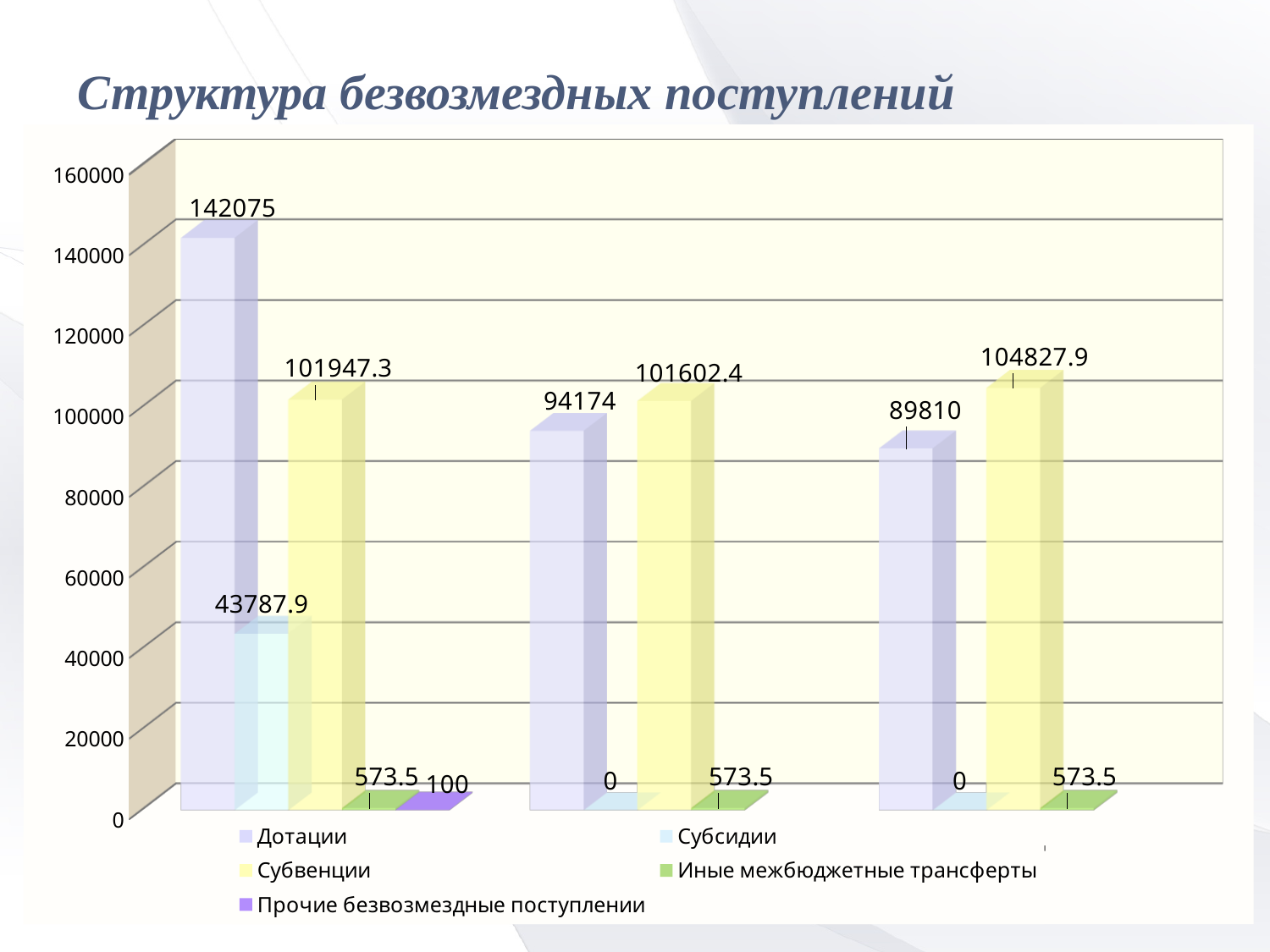
What is the value of Прочие безвозмездные поступлении in the first (leftmost) group of bars? 100 In the second (middle) group of bars, which is larger: Дотации or Субвенции? Субвенции What is the value of Субвенции in the third (rightmost) group of bars? 104827.9 Does the value of Дотации rise or fall from the first group to the third group? Fall What is the title of the chart? Структура безвозмездных поступлений What is the value of Дотации in the first (leftmost) group of bars? 142075 Which series has the highest value in the first (leftmost) group of bars? Дотации What is the value of Субсидии in the first (leftmost) group of bars? 43787.9 How many series does the legend list? 5 What kind of chart is shown on the slide? Bar chart What is the difference between Дотации in the first group (142075) and Дотации in the second group (94174)? 47901 How many groups of bars are plotted along the x axis? 3